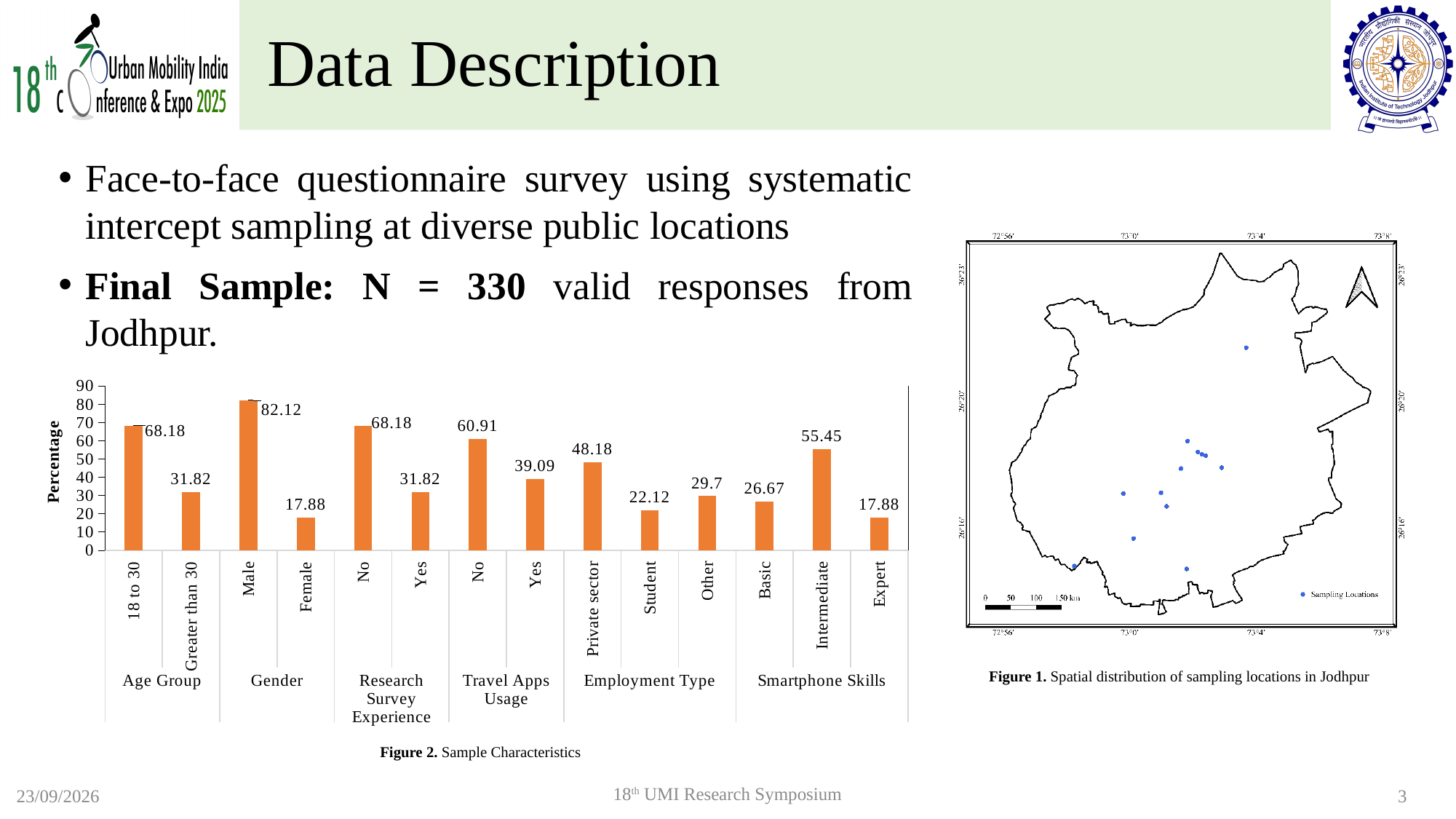
What is the percentage for Student under Employment Type? 22.12 What is the difference in percentage between Male and Female? 64.24 What percentage of respondents are in the 18 to 30 age group? 68.18 What is the label on the vertical axis of the Sample Characteristics chart? Percentage What is the percentage for Male in the Gender group of the Sample Characteristics chart? 82.12 What type of chart is Figure 2, Sample Characteristics? Bar chart Which is larger: the percentage for Private sector or for Other under Employment Type? Private sector Which bar has the highest percentage in the Sample Characteristics chart? Male What is the difference between No and Yes for Travel Apps Usage? 21.82 Within Employment Type, which category has the lowest percentage? Student How many bars are plotted in the Sample Characteristics chart? 14 What is the percentage for Intermediate under Smartphone Skills? 55.45